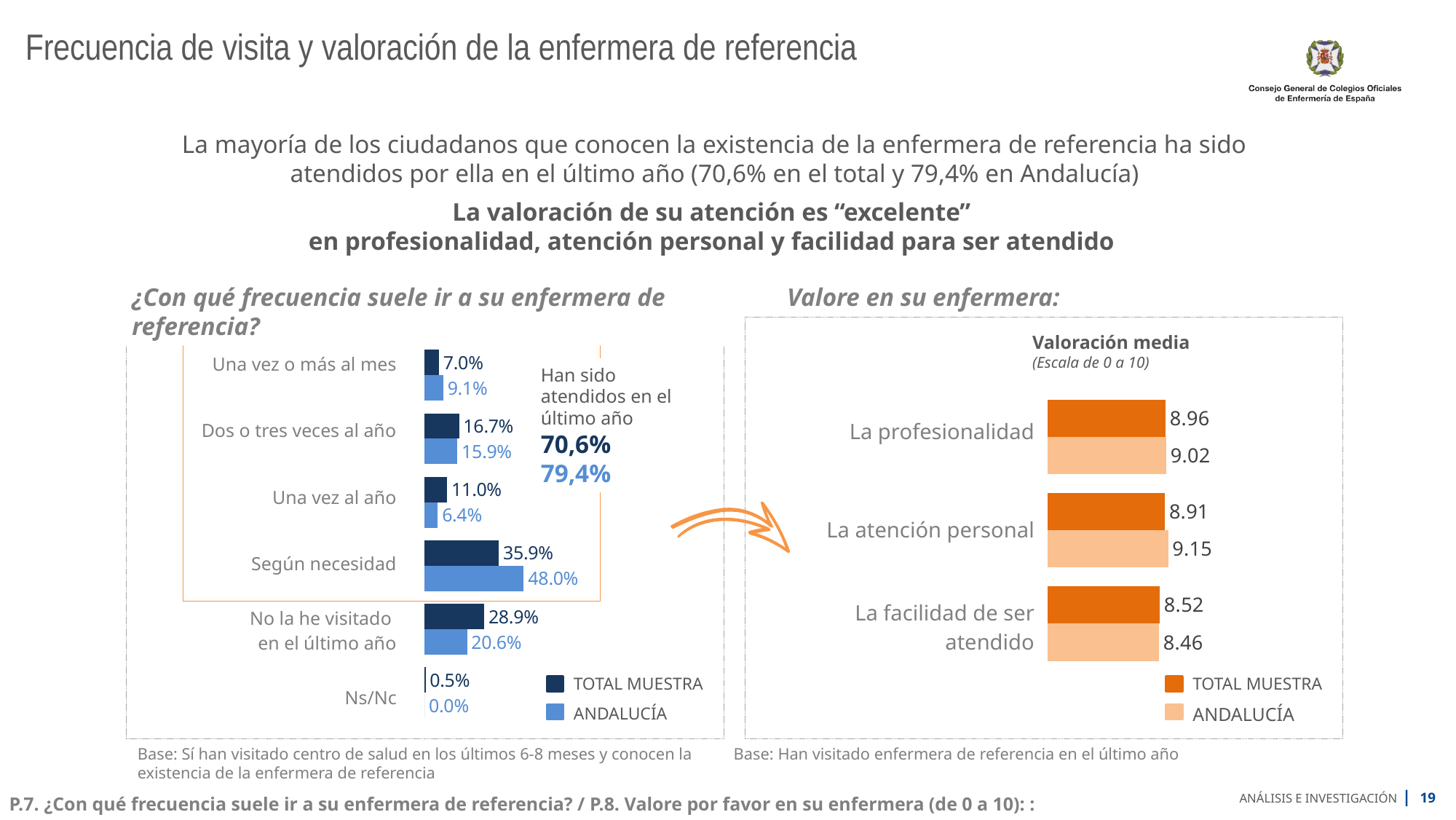
In the right chart (Valore en su enfermera), what is the difference between the ANDALUCÍA and TOTAL MUESTRA values for 'La atención personal'? 0.24 In the left chart (¿Con qué frecuencia suele ir a su enfermera de referencia?), which category has the lowest TOTAL MUESTRA value? Ns/Nc In the left chart (¿Con qué frecuencia suele ir a su enfermera de referencia?), which category has the highest ANDALUCÍA value? Según necesidad In the left chart (¿Con qué frecuencia suele ir a su enfermera de referencia?), what is the ANDALUCÍA value for 'Una vez al año'? 6.4% In the left chart (¿Con qué frecuencia suele ir a su enfermera de referencia?), what is the difference between the ANDALUCÍA and TOTAL MUESTRA values for 'Según necesidad'? 12.1% In the right chart (Valore en su enfermera), what is the ANDALUCÍA value for 'La atención personal'? 9.15 In the left chart (¿Con qué frecuencia suele ir a su enfermera de referencia?), for 'No la he visitado en el último año', which series has the larger value, TOTAL MUESTRA or ANDALUCÍA? TOTAL MUESTRA In the right chart (Valore en su enfermera), which category has the lowest ANDALUCÍA value? La facilidad de ser atendido How many categories are shown in the left chart (¿Con qué frecuencia suele ir a su enfermera de referencia?)? 6 How many series does the legend of the right chart (Valore en su enfermera) list? 2 In the left chart (¿Con qué frecuencia suele ir a su enfermera de referencia?), what is the TOTAL MUESTRA value for 'Según necesidad'? 35.9% In the right chart (Valore en su enfermera), what is the TOTAL MUESTRA value for 'La facilidad de ser atendido'? 8.52